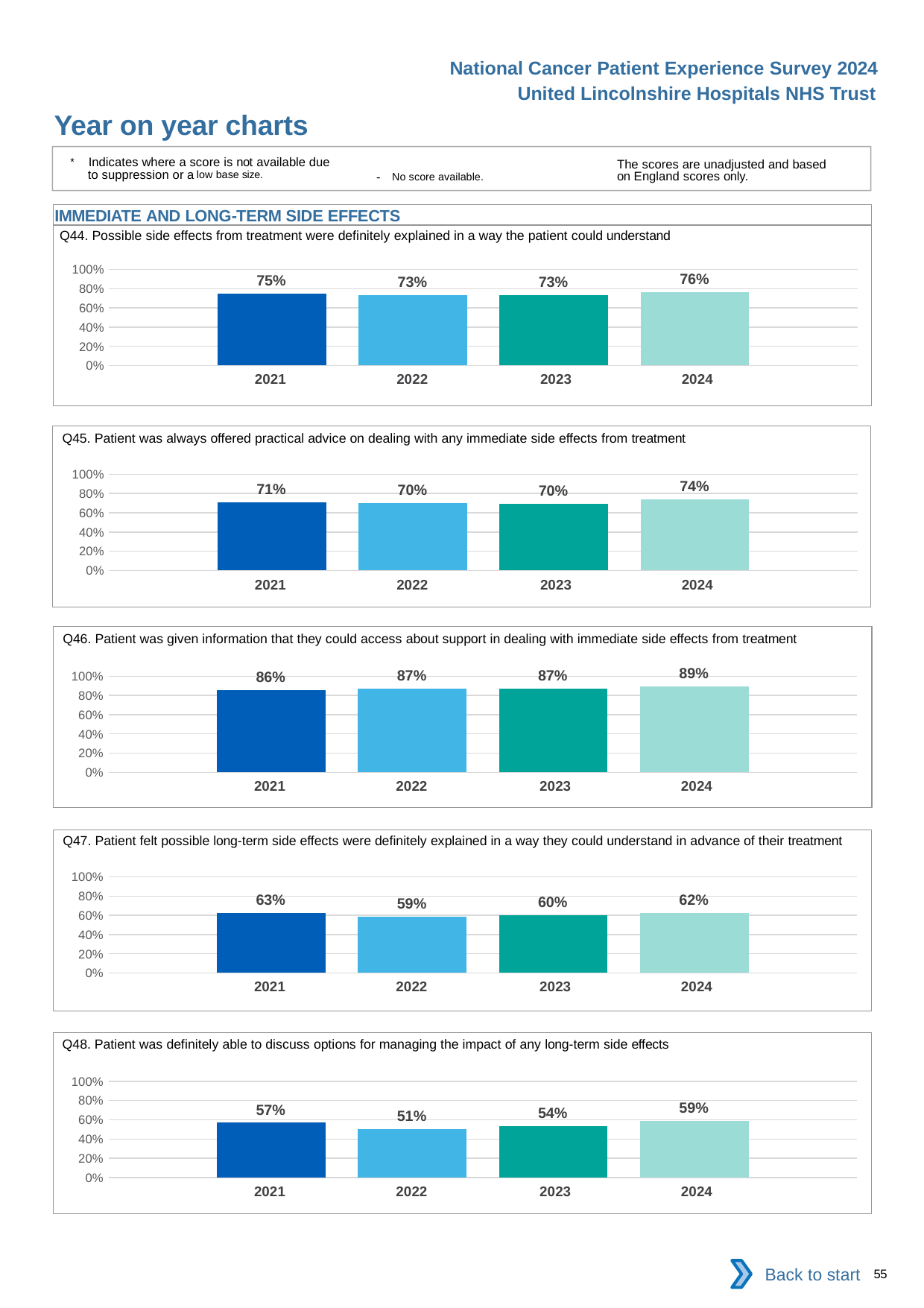
In the Q44 chart, what is the value for 2024? 76% In the Q48 chart, is the value for 2021 greater or less than 60%? less In the Q45 chart, what is the value for 2021? 71% How many charts are shown on the slide? 5 In the Q45 chart, which year has the highest value? 2024 In the Q46 chart, what is the difference between the 2024 and 2021 values? 3% In the Q48 chart, what is the difference between the 2024 and 2022 values? 8% What kind of chart is the Q46 chart? bar chart How many years are shown in the Q45 chart? 4 In the Q48 chart, what is the value for 2022? 51% In the Q47 chart, which year has the lowest value? 2022 In the Q47 chart, which is larger, the value for 2021 or the value for 2023? 2021